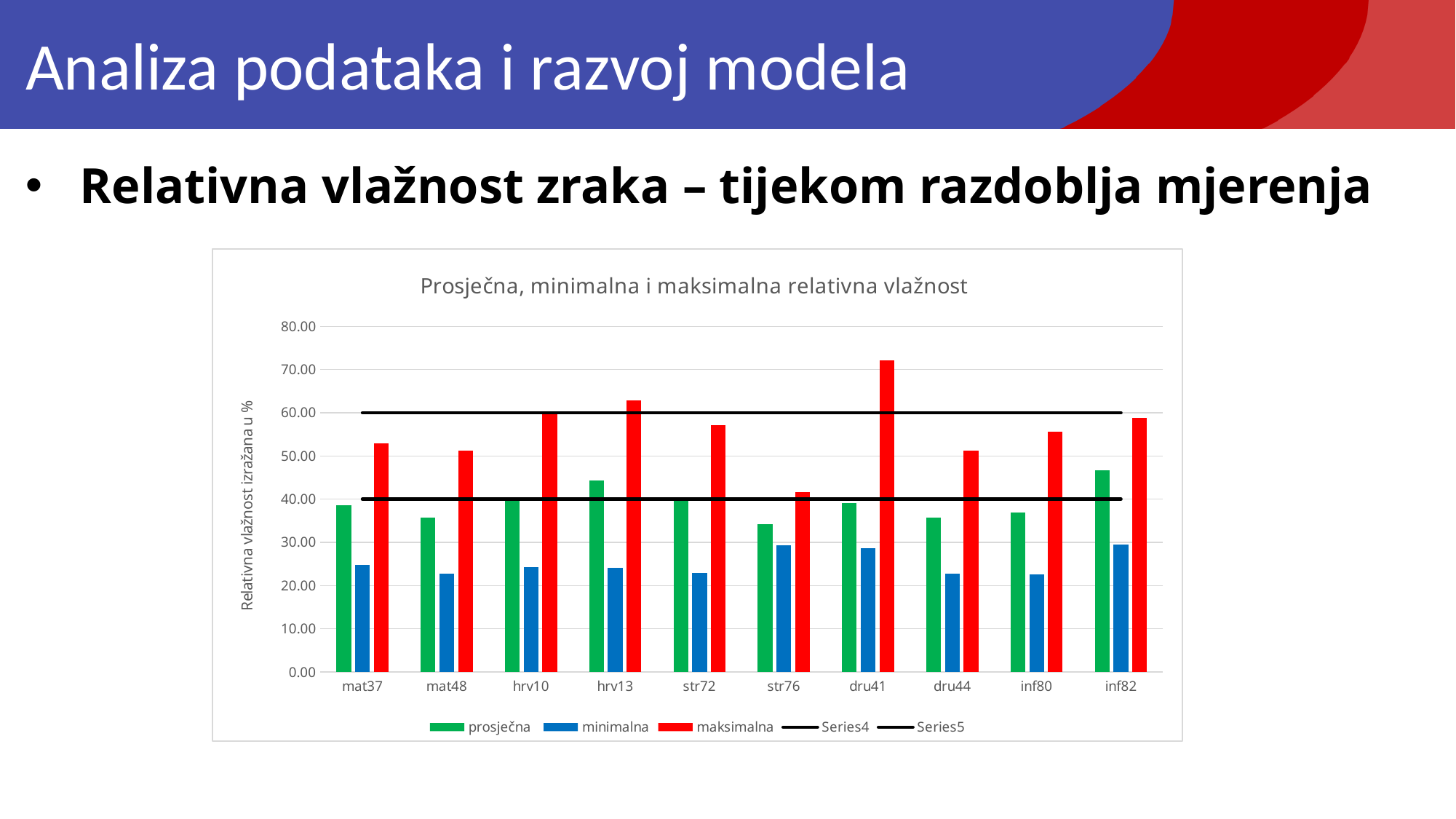
How many categories are shown on the x axis of the chart? 10 Which category has the lowest maksimalna value? str76 Is the prosječna value for hrv13 greater or less than 40.00? greater Is the maksimalna value for dru41 greater or less than 70.00? greater What is the title of the chart? Prosječna, minimalna i maksimalna relativna vlažnost What type of chart is shown on the slide? bar chart How many series does the chart legend list? 5 Which is larger, the maksimalna value for hrv13 or for str72? hrv13 Which category has the highest maksimalna value? dru41 Which category has the highest prosječna value? inf82 What is the label of the vertical axis of the chart? Relativna vlažnost izražana u %